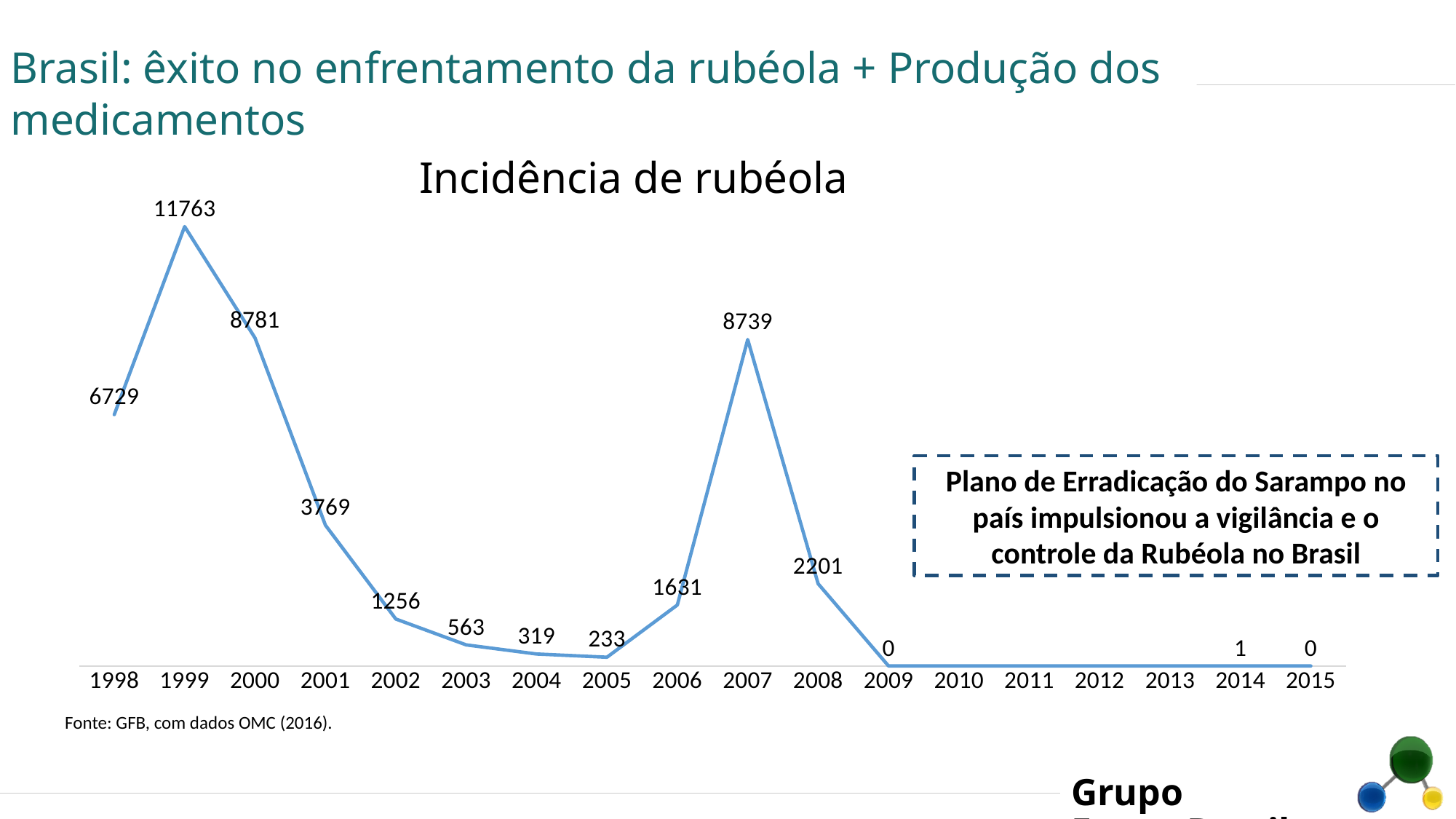
What is the difference between the values for 1999 and 2000? 2982 Which year has the highest value? 1999 Which is larger, the value for 2000 or the value for 2007? 2000 What is the value for 2005? 233 What is the value for 2014? 1 What type of chart is shown on the slide? line chart What is the title of the chart? Incidência de rubéola How many years are shown on the x axis? 18 What is the difference between the values for 2007 and 2008? 6538 Do the values rise or fall from 1999 to 2005? fall What is the value for 1999? 11763 What is the value for 2007? 8739